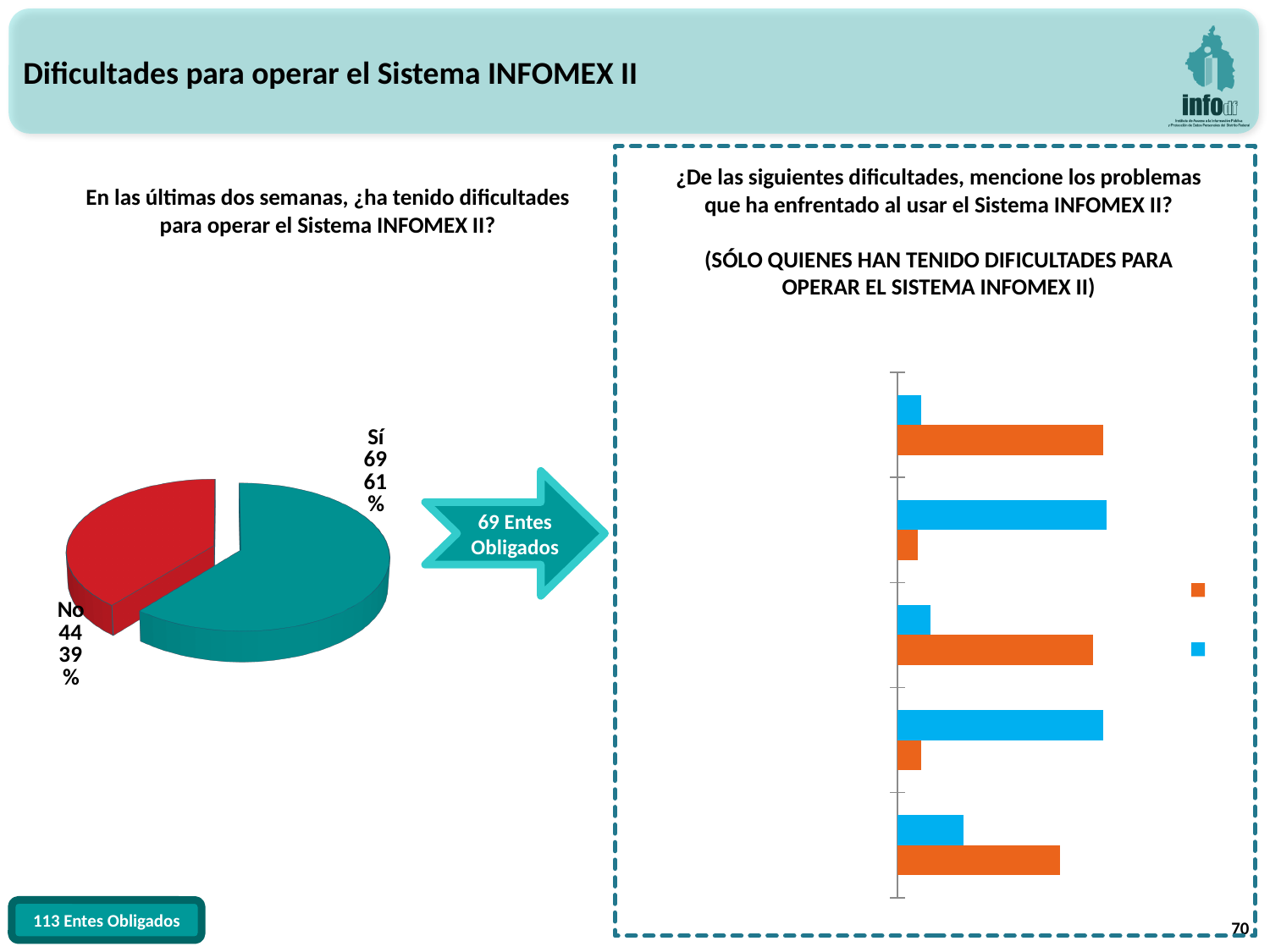
On the pie chart on the left, what is the difference between the number of "Sí" and "No" responses? 25 How many series does the legend of the bar chart on the right show? 2 On the pie chart on the left, what colour is the "No" slice? Red How many slices does the pie chart on the left have? 2 On the pie chart on the left, which category has the smallest slice? No What kind of chart is shown on the left side of the slide? Pie chart On the pie chart on the left, which answer has the larger slice, "Sí" or "No"? Sí What kind of chart is shown inside the dashed box on the right side of the slide? Bar chart On the pie chart on the left, what share of the pie does the "Sí" slice represent? 61% On the pie chart on the left, how many respondents answered "No"? 44 On the pie chart on the left, how many respondents answered "Sí"? 69 On the pie chart on the left, what share of the pie does the "No" slice represent? 39%